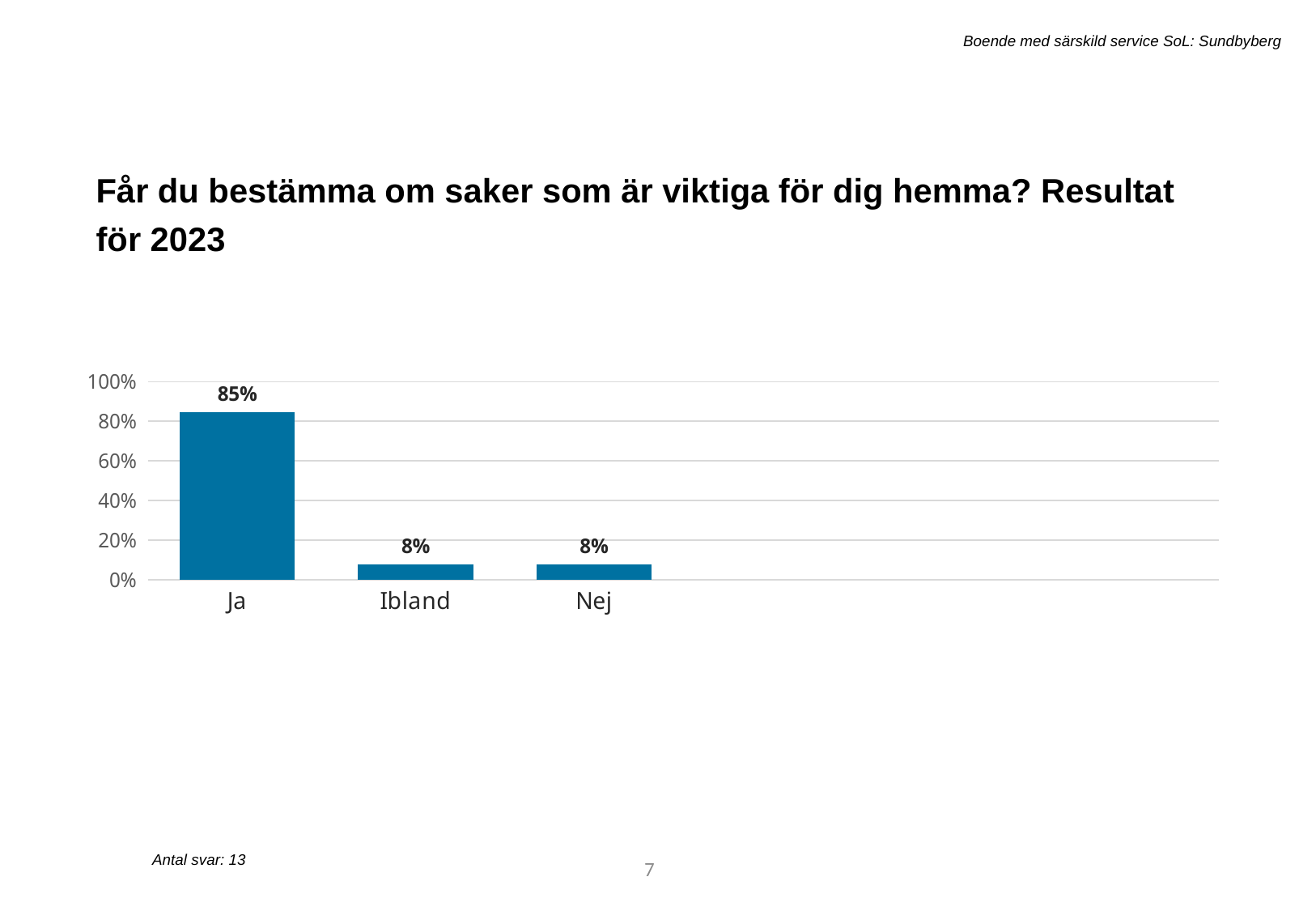
Which is larger, the value for Ja or the value for Ibland? Ja What is the value for Ja? 85% How many categories are shown on the x axis? 3 Is the value for Ja greater or less than 80%? greater Which category has the highest value? Ja What kind of chart is shown on the slide? bar chart How many responses (Antal svar) does the slide report? 13 What is the difference between the values for Ja and Nej? 77% What is the value for Ibland? 8% Is the value for Ibland greater or less than 20%? less What is the highest value shown on the y axis? 100% What is the value for Nej? 8%